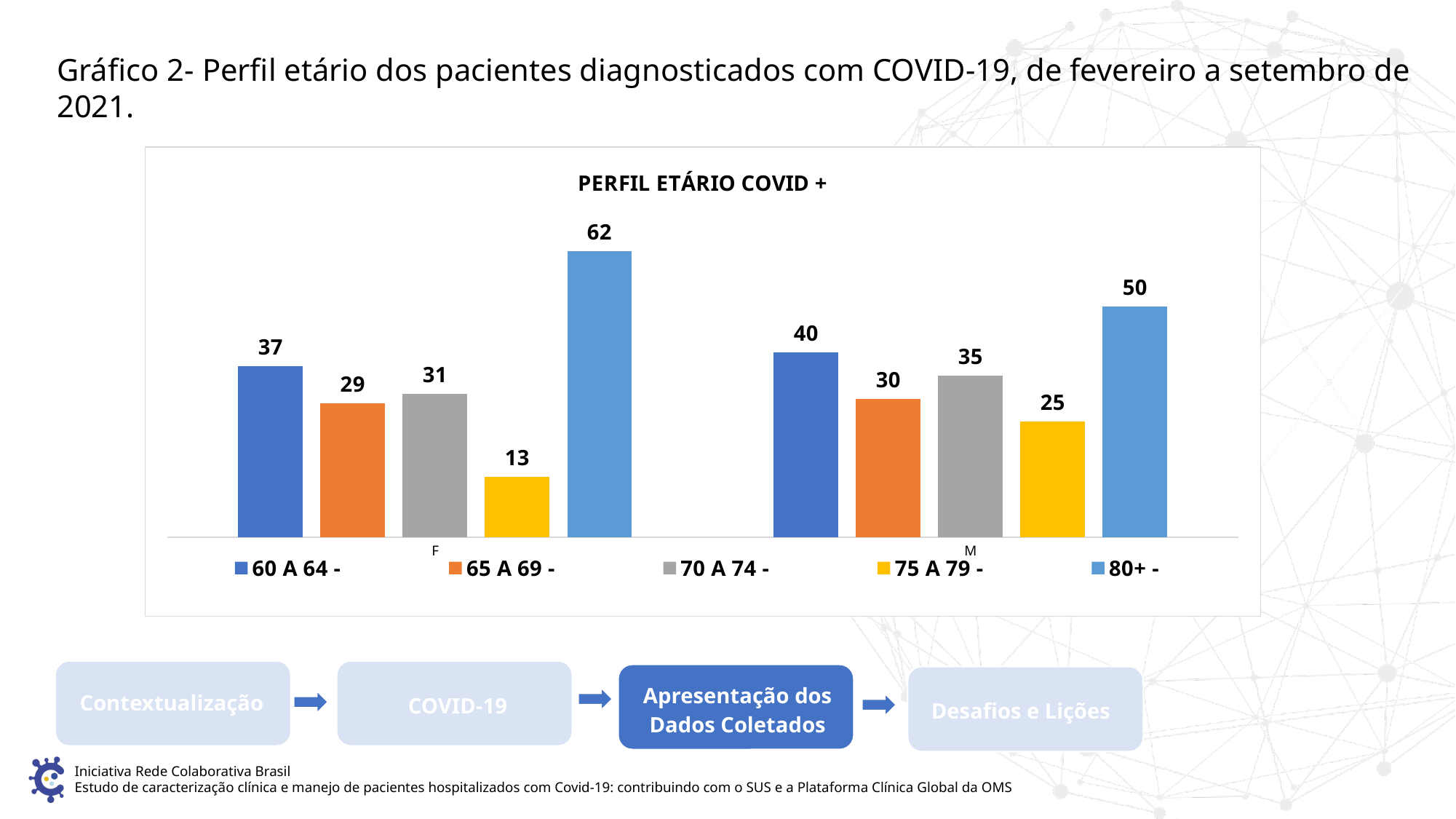
What is the title of the chart? PERFIL ETÁRIO COVID + How many categories are shown on the x axis? 2 What colour are the bars for the 75 A 79 series? yellow What is the value for the 60 A 64 series in the F group? 37 How many series does the legend list? 5 Which age series has the lowest value in the F group? 75 A 79 What kind of chart is shown? bar chart Which age series has the highest value in the M group? 80+ What is the value for the 75 A 79 series in the M group? 25 What is the difference between the 80+ values for F and M? 12 Which is larger, the 70 A 74 value for F or for M? M What is the value for the 80+ series in the F group? 62